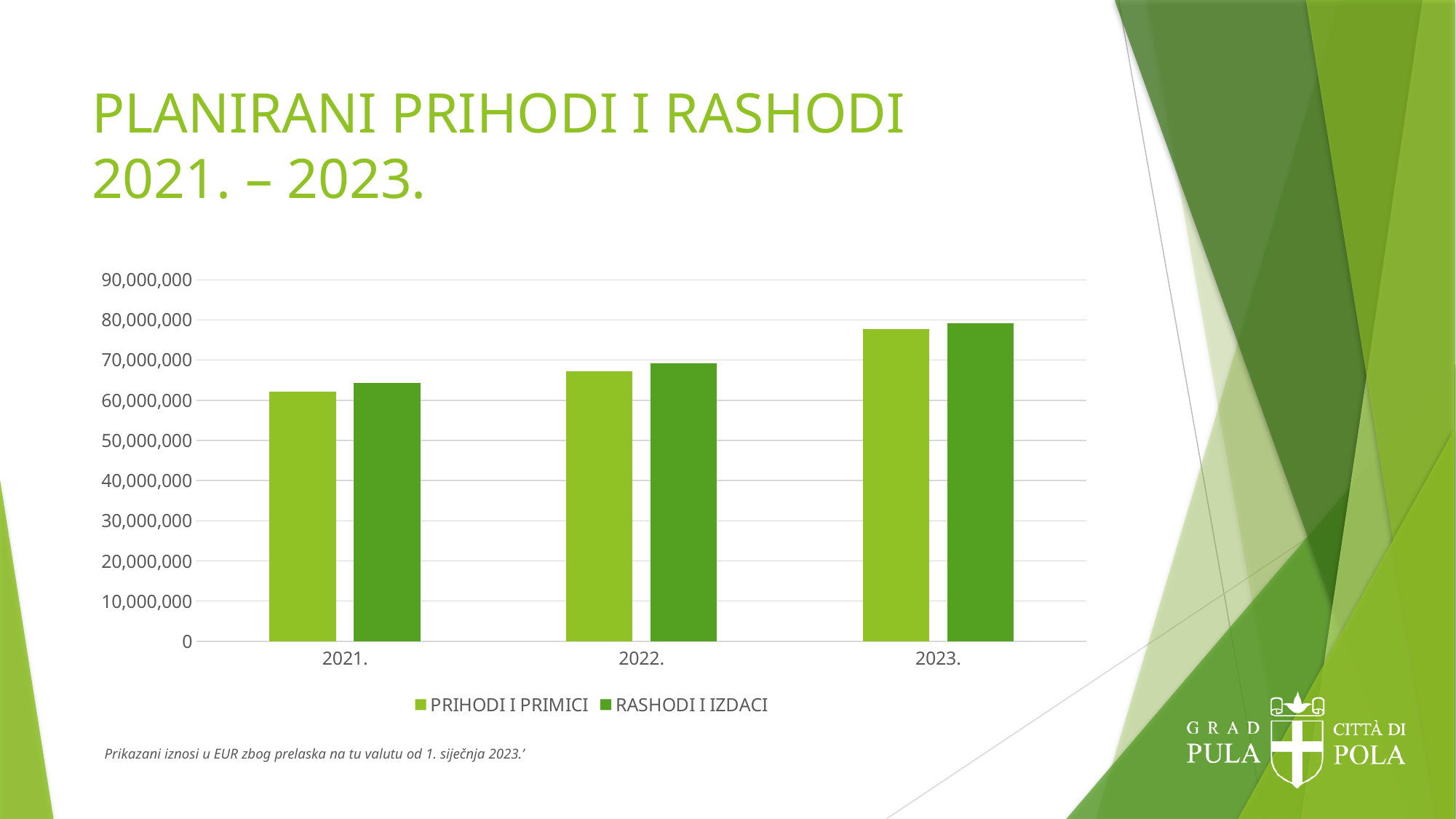
Which year has the highest value for PRIHODI I PRIMICI? 2023. What is the title of the slide containing the chart? PLANIRANI PRIHODI I RASHODI 2021. – 2023. Which is larger: PRIHODI I PRIMICI in 2022. or PRIHODI I PRIMICI in 2023.? PRIHODI I PRIMICI in 2023. Which year has the lowest value for RASHODI I IZDACI? 2021. How many years are shown on the x axis? 3 Is the value for PRIHODI I PRIMICI in 2021. greater or less than 60,000,000? greater Is the value for PRIHODI I PRIMICI in 2023. greater or less than 70,000,000? greater What kind of chart is shown on the slide? bar chart Do the values for RASHODI I IZDACI rise or fall from 2021. to 2023.? rise How many series does the legend list? 2 Is the value for RASHODI I IZDACI in 2021. greater or less than 70,000,000? less